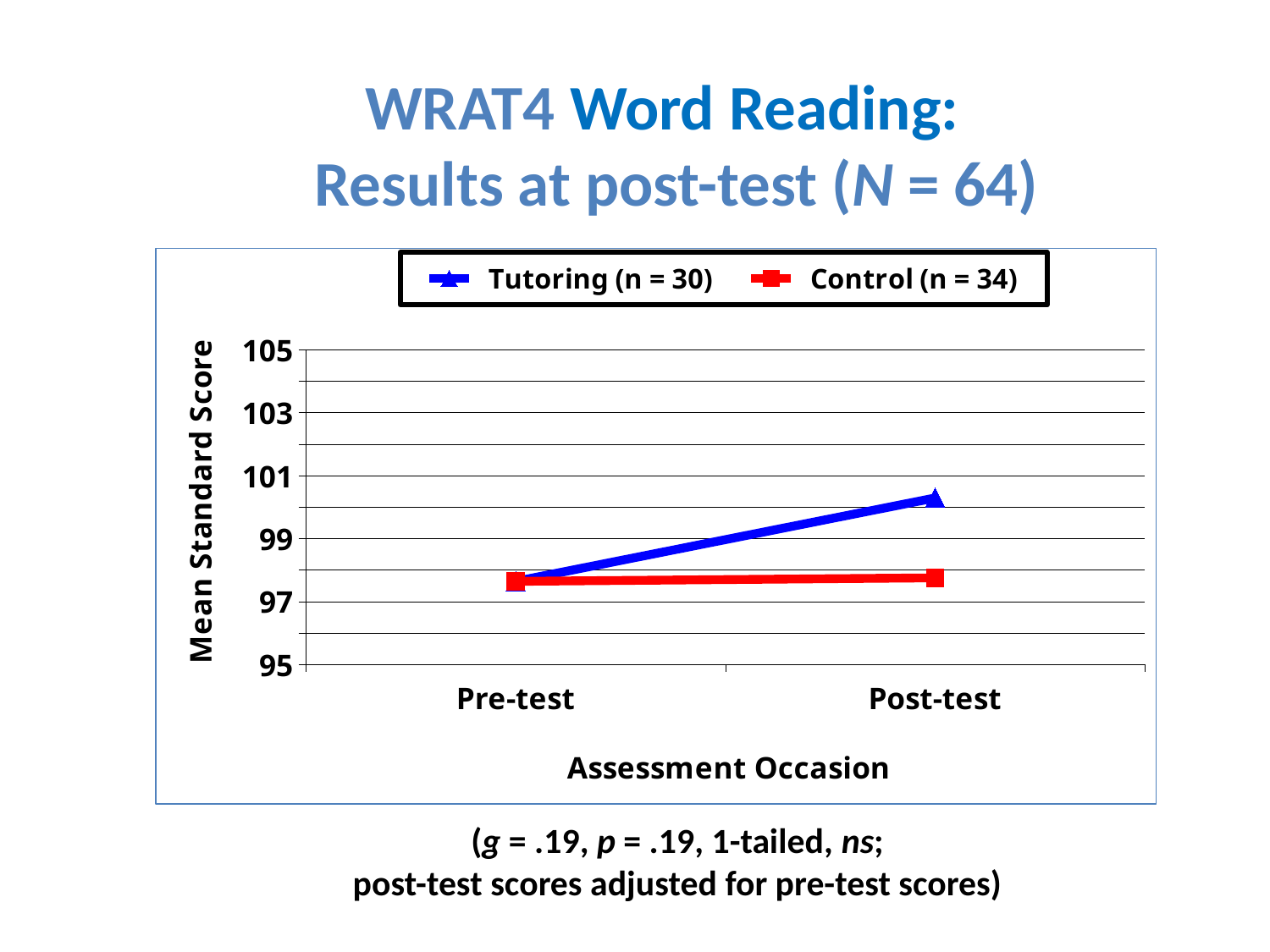
Is the Post-test value for Control (n = 34) greater or less than 99? less Is the Post-test value for Control (n = 34) greater or less than 97? greater What colour is the line for the Control (n = 34) series? red Does the Tutoring (n = 30) series rise or fall from Pre-test to Post-test? rise Which series has the higher mean standard score at Post-test? Tutoring (n = 30) How many series does the legend list? 2 What kind of chart is shown on the slide? line chart Is the Post-test value for Tutoring (n = 30) greater or less than 99? greater How many assessment occasions are shown on the x axis? 2 What is the title of the y axis? Mean Standard Score